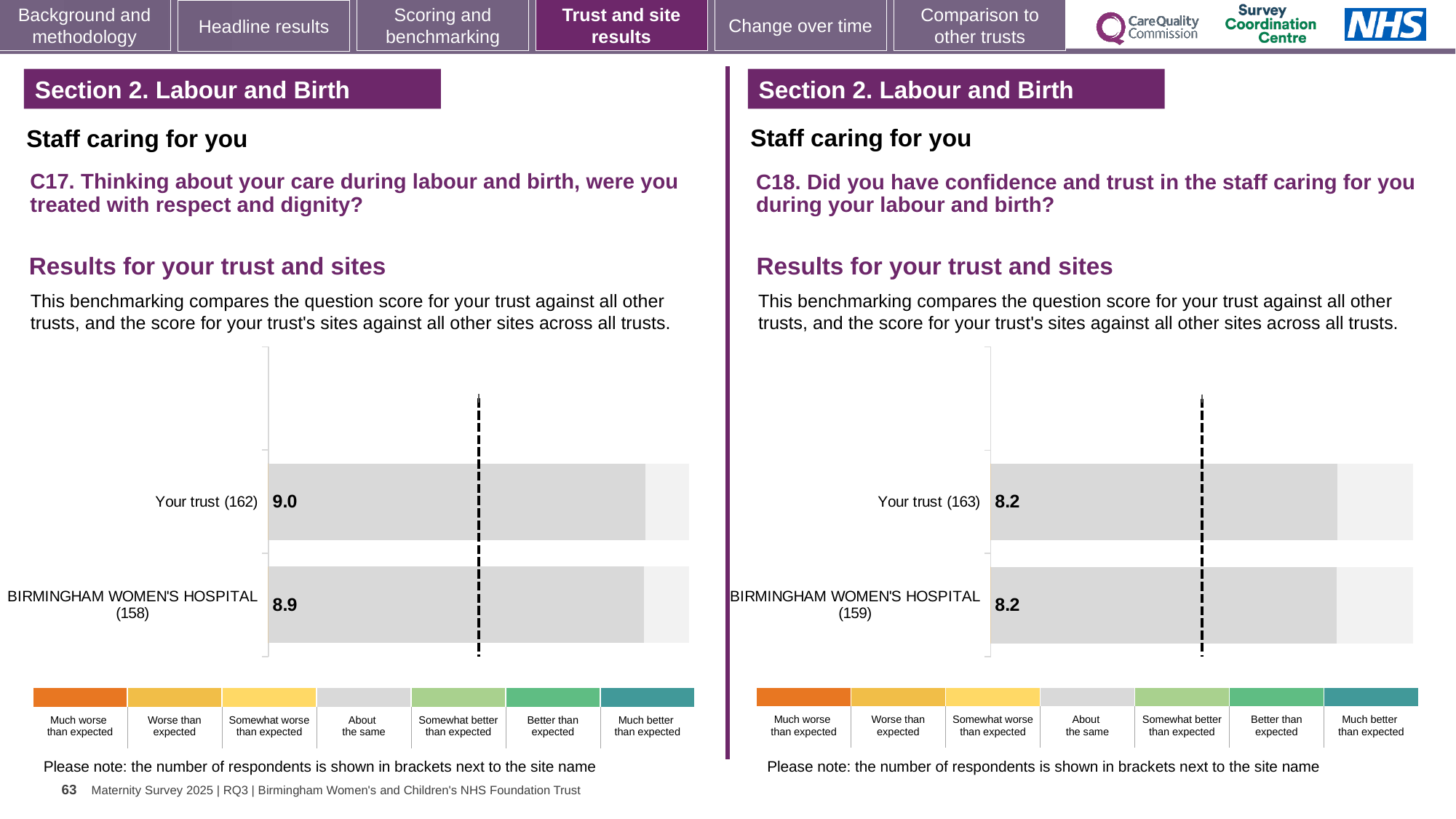
How many bars are plotted in the left chart (C17)? 2 In the right chart (C18), how many respondents are shown in brackets for BIRMINGHAM WOMEN'S HOSPITAL? 159 In the right chart (C18), what is the difference between the Your trust score and the BIRMINGHAM WOMEN'S HOSPITAL score? 0.0 Which chart has the higher score for Your trust, the left chart (C17) or the right chart (C18)? The left chart (C17) In the right chart (C18), what is the score for Your trust? 8.2 In the left chart (C17), what is the score for Your trust? 9.0 In the left chart (C17), what is the difference between the Your trust score and the BIRMINGHAM WOMEN'S HOSPITAL score? 0.1 How many bars are plotted in the right chart (C18)? 2 In the left chart (C17), how many respondents are shown in brackets for Your trust? 162 What type of chart is used in the left chart (C17)? Bar chart In the right chart (C18), what is the score for BIRMINGHAM WOMEN'S HOSPITAL? 8.2 In the left chart (C17), what is the score for BIRMINGHAM WOMEN'S HOSPITAL? 8.9